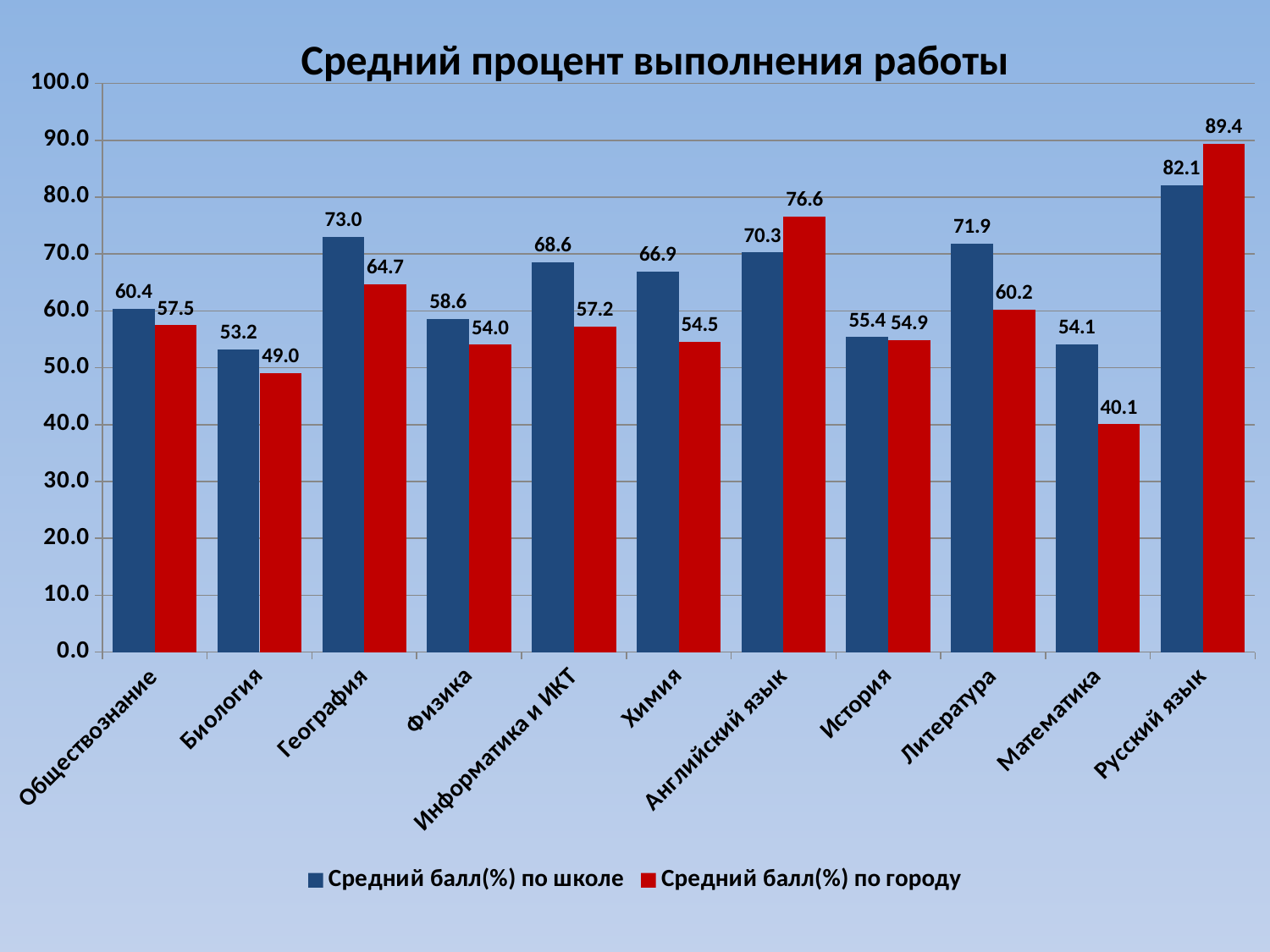
For Русский язык, which is larger: Средний балл(%) по школе or Средний балл(%) по городу? Средний балл(%) по городу Which subject has the highest value for Средний балл(%) по школе? Русский язык What is the value of Средний балл(%) по школе for География? 73.0 What is the value of Средний балл(%) по городу for Математика? 40.1 How many series does the legend list? 2 How many subjects are shown on the x axis? 11 What is the title of the chart? Средний процент выполнения работы What is the difference between Средний балл(%) по школе and Средний балл(%) по городу for Математика? 14.0 Is the value of Средний балл(%) по школе for Литература greater or less than 70.0? greater What kind of chart is shown on the slide? Bar chart Which subject has the lowest value for Средний балл(%) по городу? Математика What is the value of Средний балл(%) по городу for Английский язык? 76.6